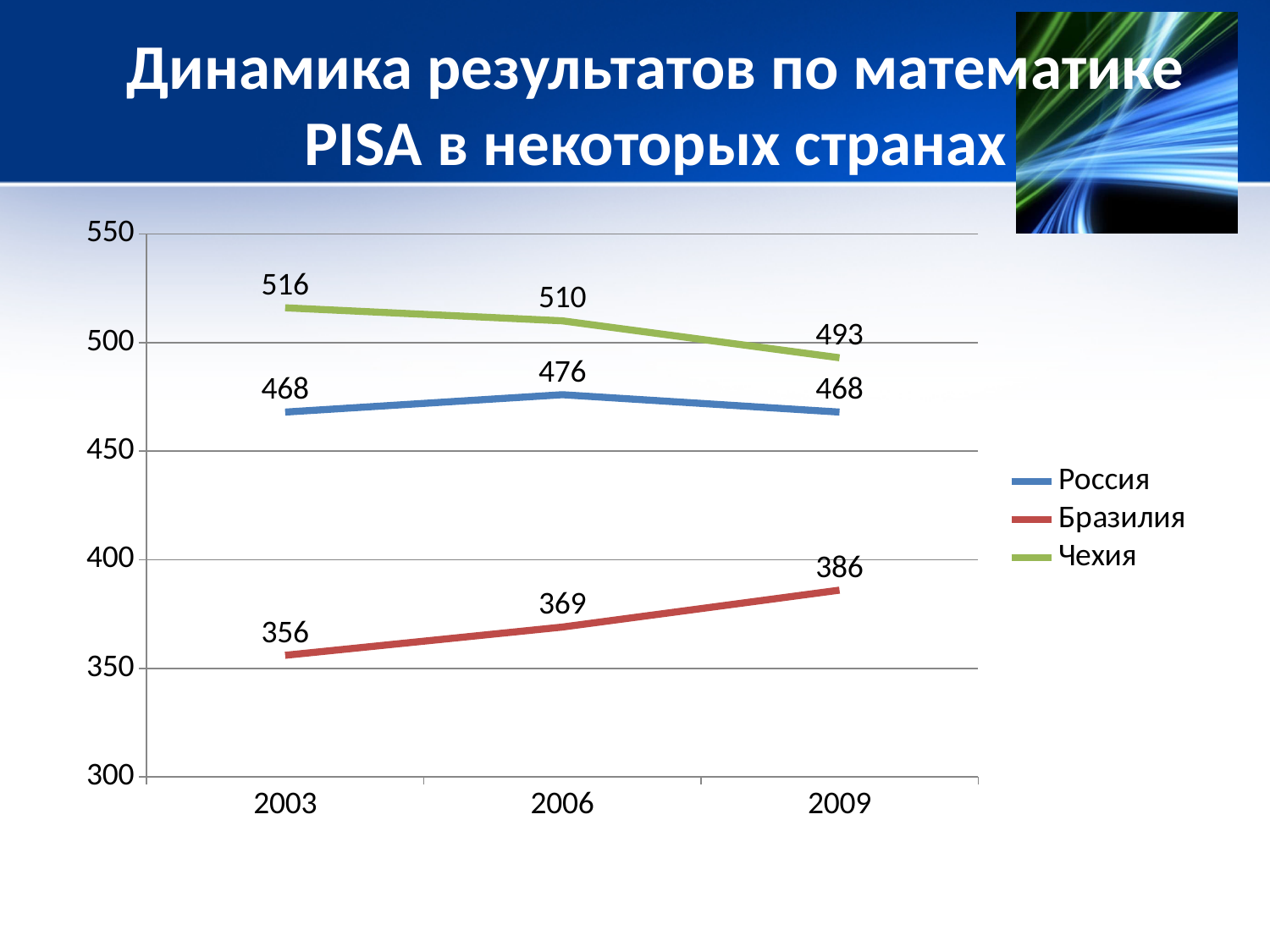
Which country had the higher score in 2006, Russia (Россия) or the Czech Republic (Чехия)? Чехия What was the Czech Republic's (Чехия) score in 2009? 493 What is the difference between Russia's (Россия) and Brazil's (Бразилия) scores in 2009? 82 How many series does the legend list? 3 In which year did Brazil (Бразилия) have its lowest score? 2003 By how much did the Czech Republic's (Чехия) score fall from 2003 to 2009? 23 How many years are shown on the x axis? 3 What was Russia's (Россия) PISA mathematics score in 2006? 476 In which year did the Czech Republic (Чехия) have its highest score? 2003 What was Brazil's (Бразилия) score in 2003? 356 Does Brazil's (Бразилия) score rise or fall from 2003 to 2009? rise What kind of chart is shown on the slide? line chart